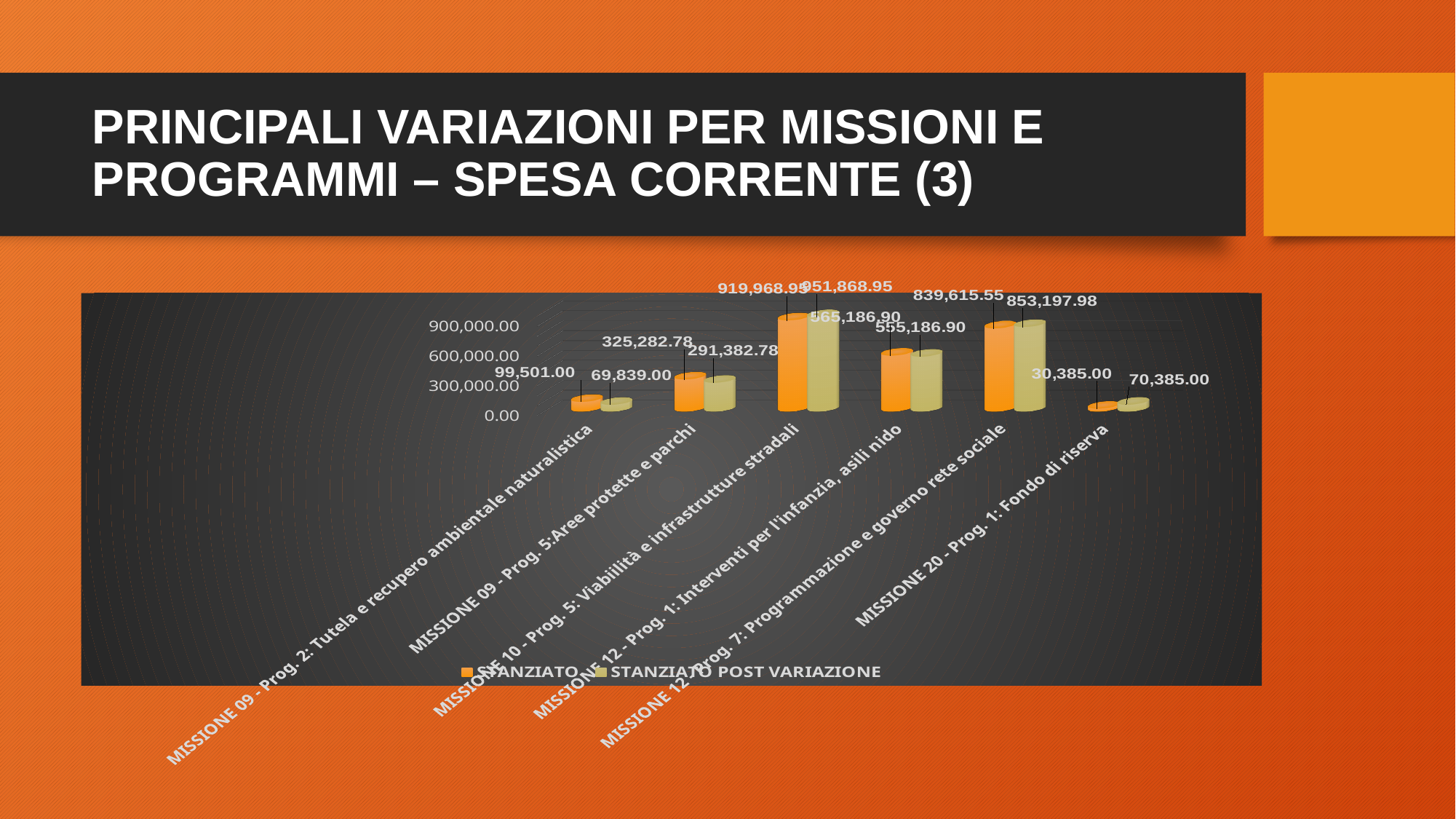
Which category has the highest STANZIATO POST VARIAZIONE value? MISSIONE 10 - Prog. 5: Viabilità e infrastrutture stradali What is the STANZIATO value for MISSIONE 12 - Prog. 7: Programmazione e governo rete sociale? 839,615.55 For MISSIONE 12 - Prog. 1: Interventi per l'infanzia, asili nido, which is larger: STANZIATO or STANZIATO POST VARIAZIONE? STANZIATO What is the difference between the STANZIATO and STANZIATO POST VARIAZIONE values for MISSIONE 09 - Prog. 2: Tutela e recupero ambientale naturalistica? 29,662.00 What is the STANZIATO value for MISSIONE 10 - Prog. 5: Viabilità e infrastrutture stradali? 919,968.95 What is the difference between the STANZIATO POST VARIAZIONE and STANZIATO values for MISSIONE 20 - Prog. 1: Fondo di riserva? 40,000.00 How many series does the legend list? 2 How many categories are shown on the chart? 6 What is the STANZIATO POST VARIAZIONE value for MISSIONE 09 - Prog. 5: Aree protette e parchi? 291,382.78 Which category has the lowest STANZIATO value? MISSIONE 20 - Prog. 1: Fondo di riserva What is the STANZIATO POST VARIAZIONE value for MISSIONE 20 - Prog. 1: Fondo di riserva? 70,385.00 What kind of chart is shown on the slide? Bar chart